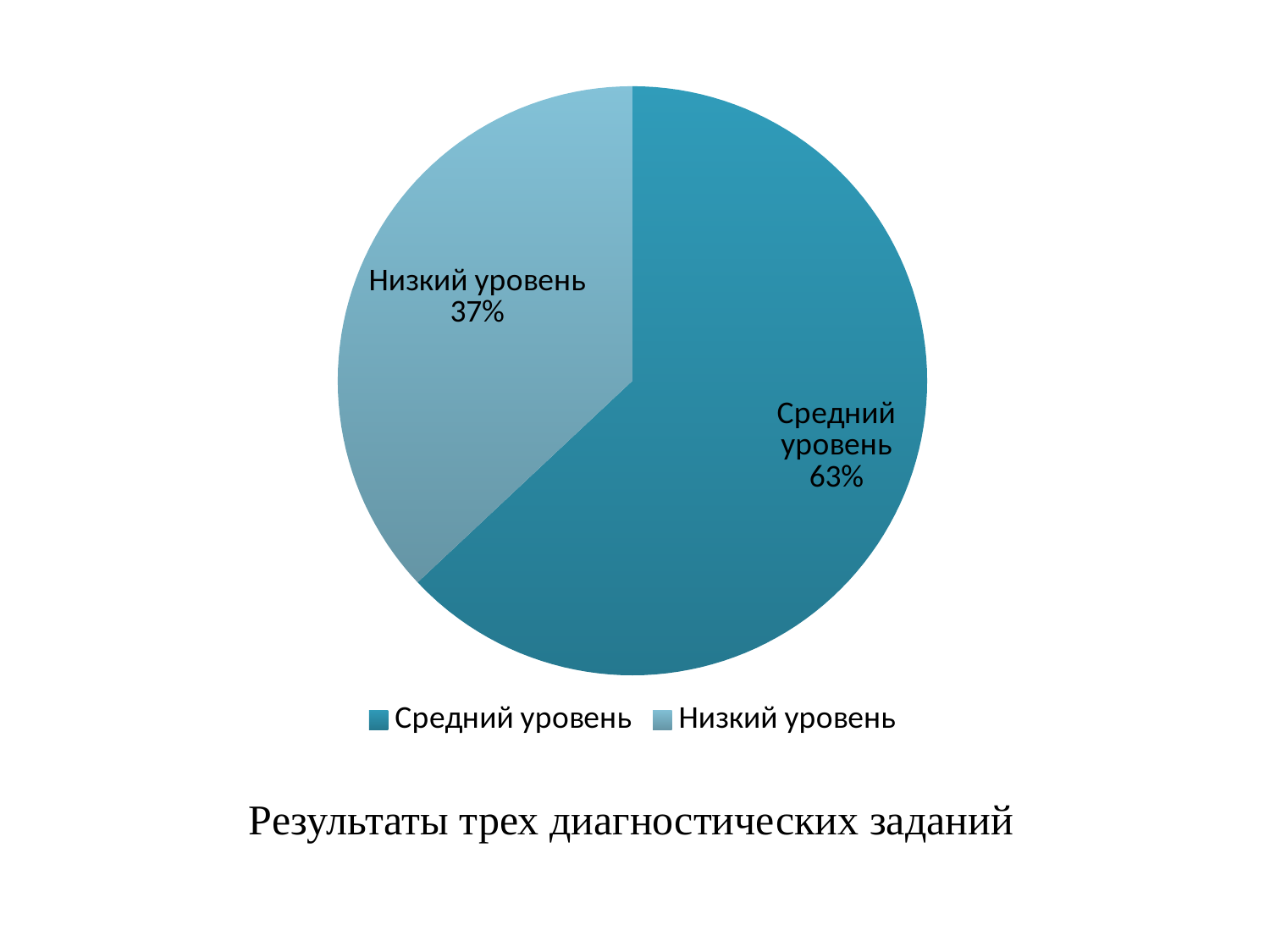
What share of the pie does "Средний уровень" have? 63% How many slices does the pie chart have? 2 Which category has the smallest slice of the pie? Низкий уровень What kind of chart is shown on the slide? pie chart Which legend entry is shown with the darker teal colour? Средний уровень What is the caption text below the chart? Результаты трех диагностических заданий What is the difference in percentage points between "Средний уровень" and "Низкий уровень"? 26 What share of the pie does "Низкий уровень" have? 37% How many entries does the legend list? 2 Which category has the largest slice of the pie? Средний уровень Which is larger: the slice for "Средний уровень" or the slice for "Низкий уровень"? Средний уровень